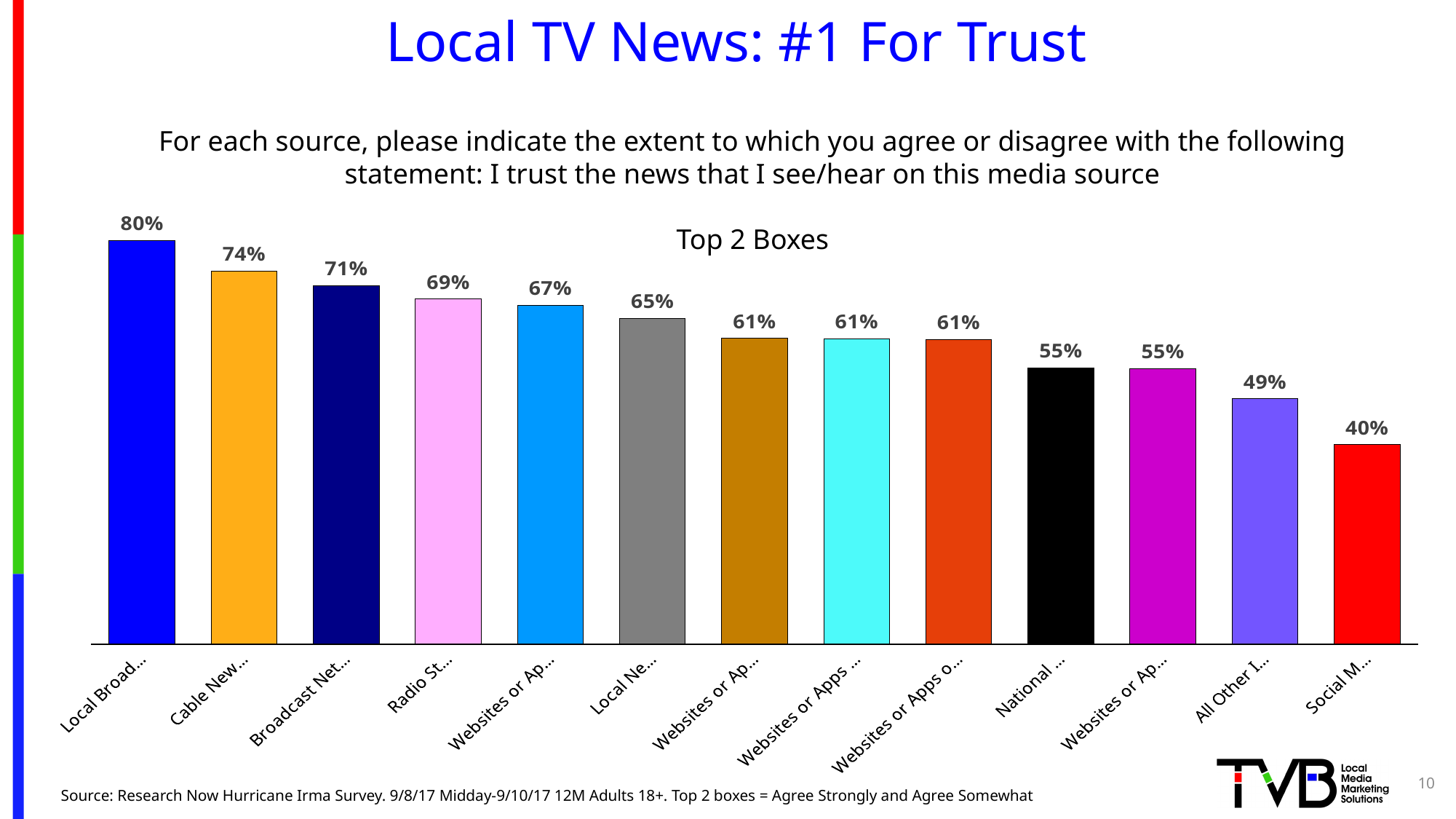
What is the value for Social M... in the Top 2 Boxes chart? 40% Which category has the highest value in the Top 2 Boxes chart? Local Broad... What is the value for Radio St... in the Top 2 Boxes chart? 69% What is the difference between the values for Cable New... and Radio St...? 5% Do the values rise or fall from left to right across the chart? Fall What is the value for Local Broad... in the Top 2 Boxes chart? 80% What is the value for All Other I... in the Top 2 Boxes chart? 49% How many bars are shown in the Top 2 Boxes chart? 13 Which has a larger value, Cable New... or Broadcast Net...? Cable New... What is the difference between the values for Local Broad... and Social M...? 40% Which category has the lowest value in the Top 2 Boxes chart? Social M... What kind of chart is shown on the slide? Bar chart